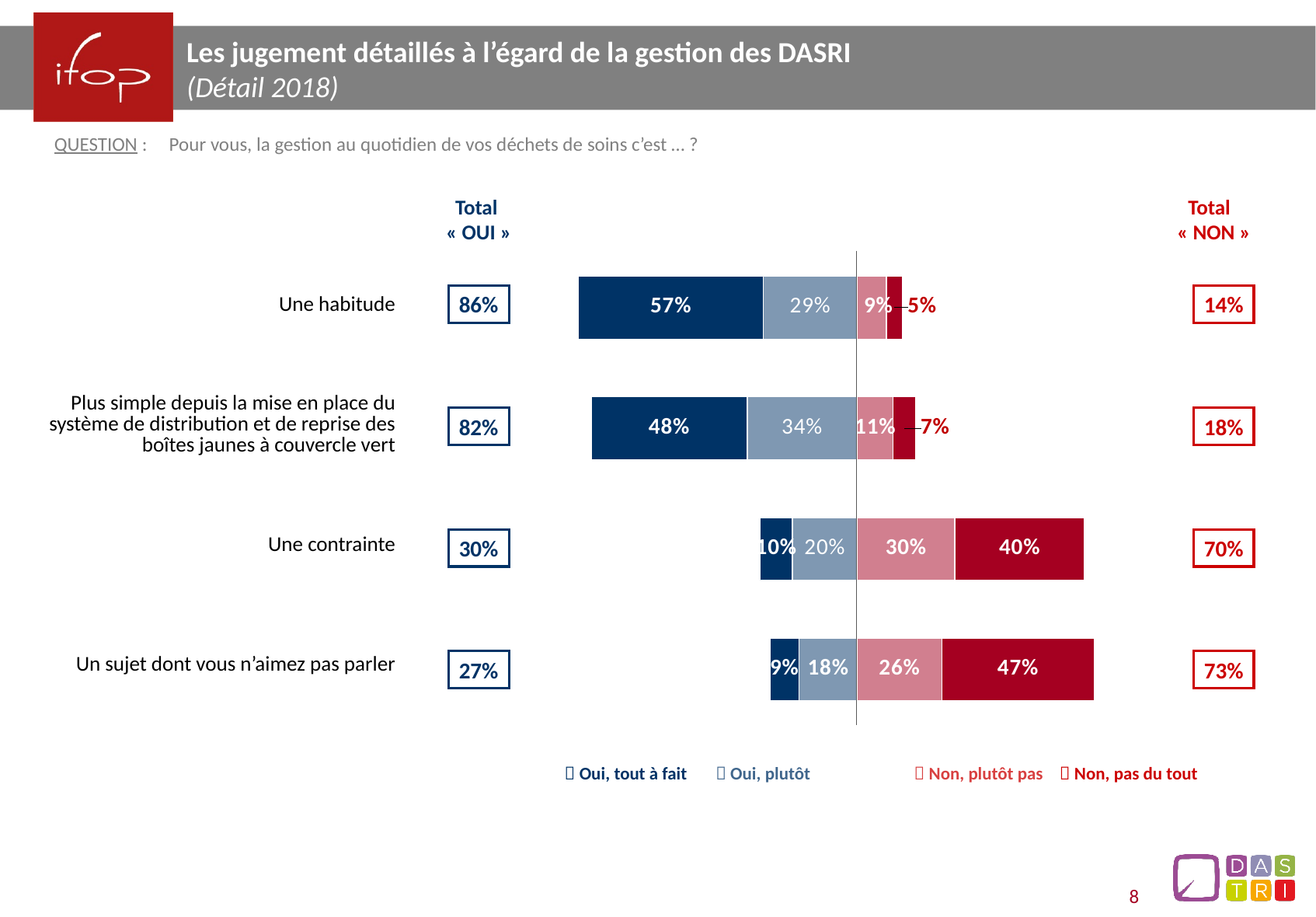
What is the difference between the "Oui, plutôt" values for "Plus simple depuis la mise en place du système..." and "Une habitude"? 5% What kind of chart is shown on the slide? Stacked bar chart What is the Total « OUI » for "Plus simple depuis la mise en place du système de distribution et de reprise des boîtes jaunes à couvercle vert"? 82% How many series does the legend list? 4 What is the total of the two "Non" segments for "Une habitude"? 14% What is the "Non, pas du tout" value for "Un sujet dont vous n'aimez pas parler"? 47% What percentage answered "Oui, tout à fait" for "Une habitude"? 57% How many items (categories) are shown in the chart? 4 Which item has the highest Total « OUI »? Une habitude Which item has the lowest "Oui, tout à fait" value? Un sujet dont vous n'aimez pas parler What is the Total « NON » for "Une contrainte"? 70% Which is larger: the "Non, pas du tout" value for "Une contrainte" or for "Un sujet dont vous n'aimez pas parler"? Un sujet dont vous n'aimez pas parler